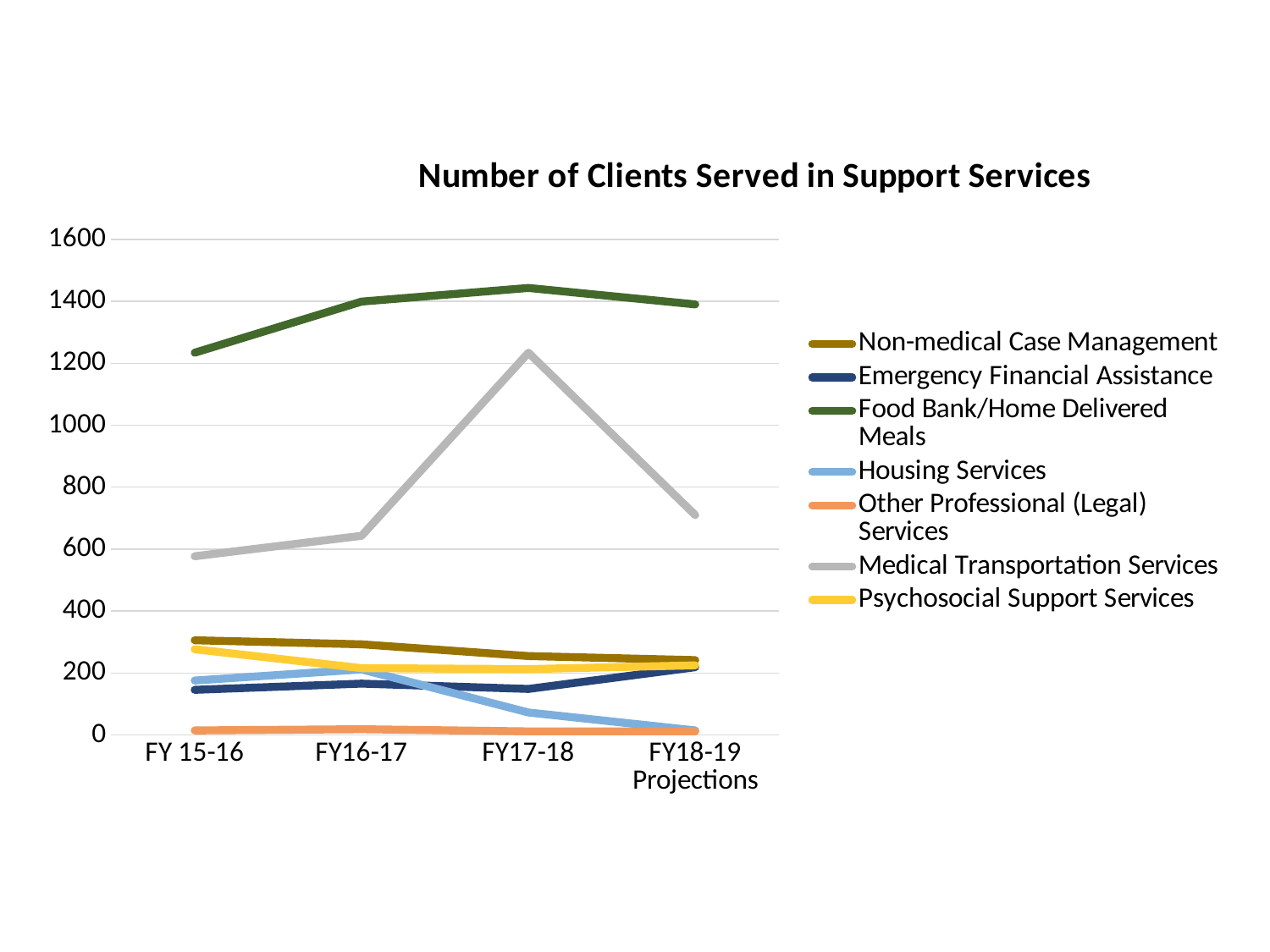
What is the title of the chart? Number of Clients Served in Support Services For Medical Transportation Services, which is larger: the FY17-18 value or the FY18-19 Projections value? FY17-18 Does the Housing Services line rise or fall from FY16-17 to FY18-19 Projections? fall What kind of chart is shown on the slide? line chart Which series has the highest value in FY17-18? Food Bank/Home Delivered Meals In FY 15-16, which is larger: Housing Services or Emergency Financial Assistance? Housing Services Is the value for Medical Transportation Services in FY17-18 greater or less than 1000? greater Is the value for Food Bank/Home Delivered Meals in FY 15-16 greater or less than 1000? greater How many fiscal-year categories are shown on the x axis? 4 How many series does the legend list? 7 Is the value for Non-medical Case Management in FY 15-16 greater or less than 400? less Which series has the lowest value in FY 15-16? Other Professional (Legal) Services